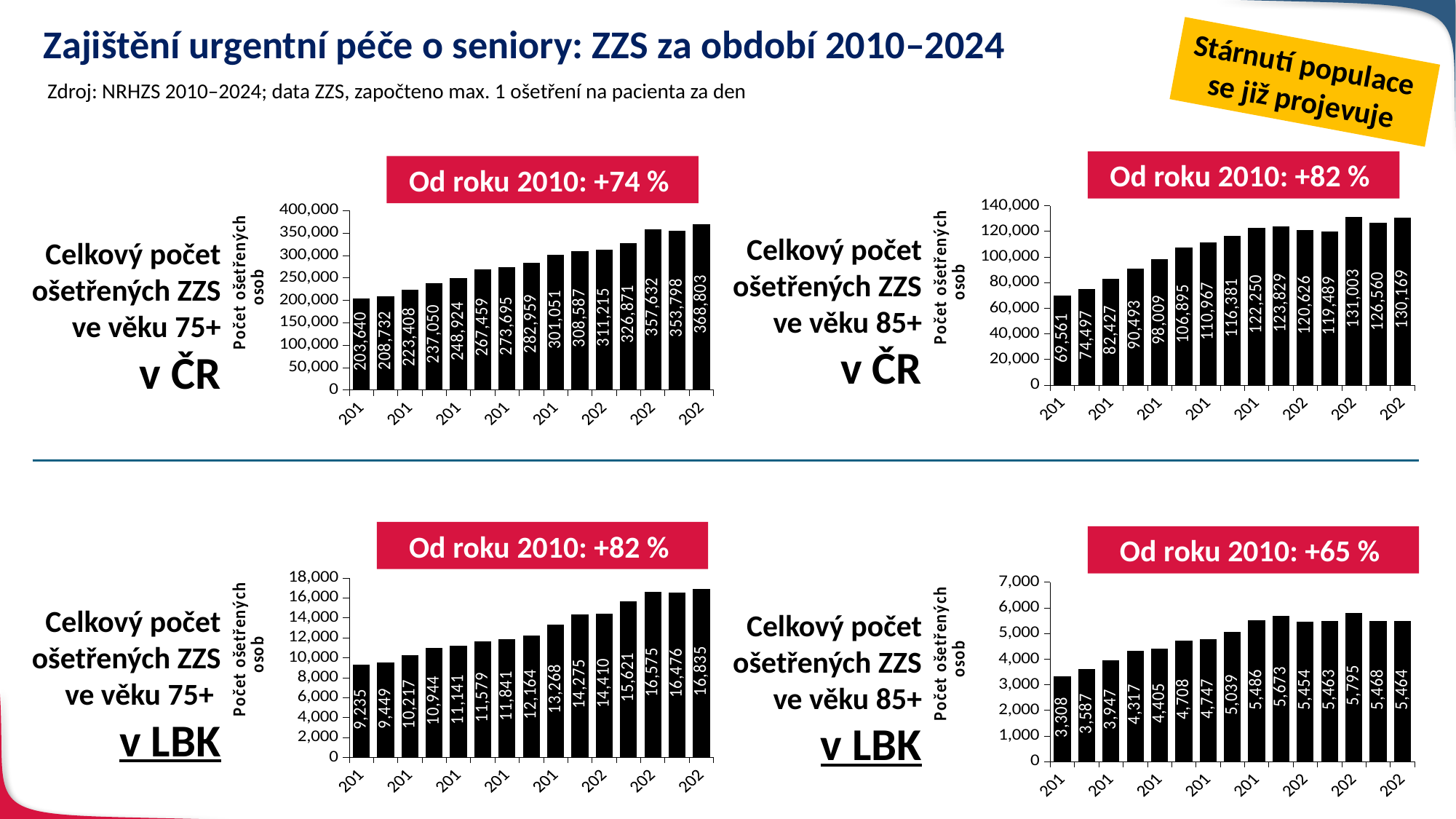
In the top-right chart (85+ in ČR), is the value of the last bar greater or less than 120,000? greater In the top-left chart (75+ in ČR), what is the value of the first bar? 203,640 In the top-right chart (85+ in ČR), what is the highest value shown? 131,003 In the top-right chart (85+ in ČR), what is the lowest value shown? 69,561 In the bottom-right chart (85+ in LBK), what is the highest value shown? 5,795 In the top-left chart (75+ in ČR), what is the value of the last bar? 368,803 What percentage increase since 2010 is stated above the bottom-right chart (85+ in LBK)? +65 % In the bottom-right chart (85+ in LBK), which is larger: the first bar or the last bar? the last bar (5,464) How many bars does the top-left chart (75+ in ČR) contain? 15 What type of chart is used in the bottom-left chart (75+ in LBK)? bar chart In the bottom-left chart (75+ in LBK), what is the difference between the last bar (16,835) and the first bar (9,235)? 7,600 In the top-left chart (75+ in ČR), do the values generally rise or fall from left to right? rise